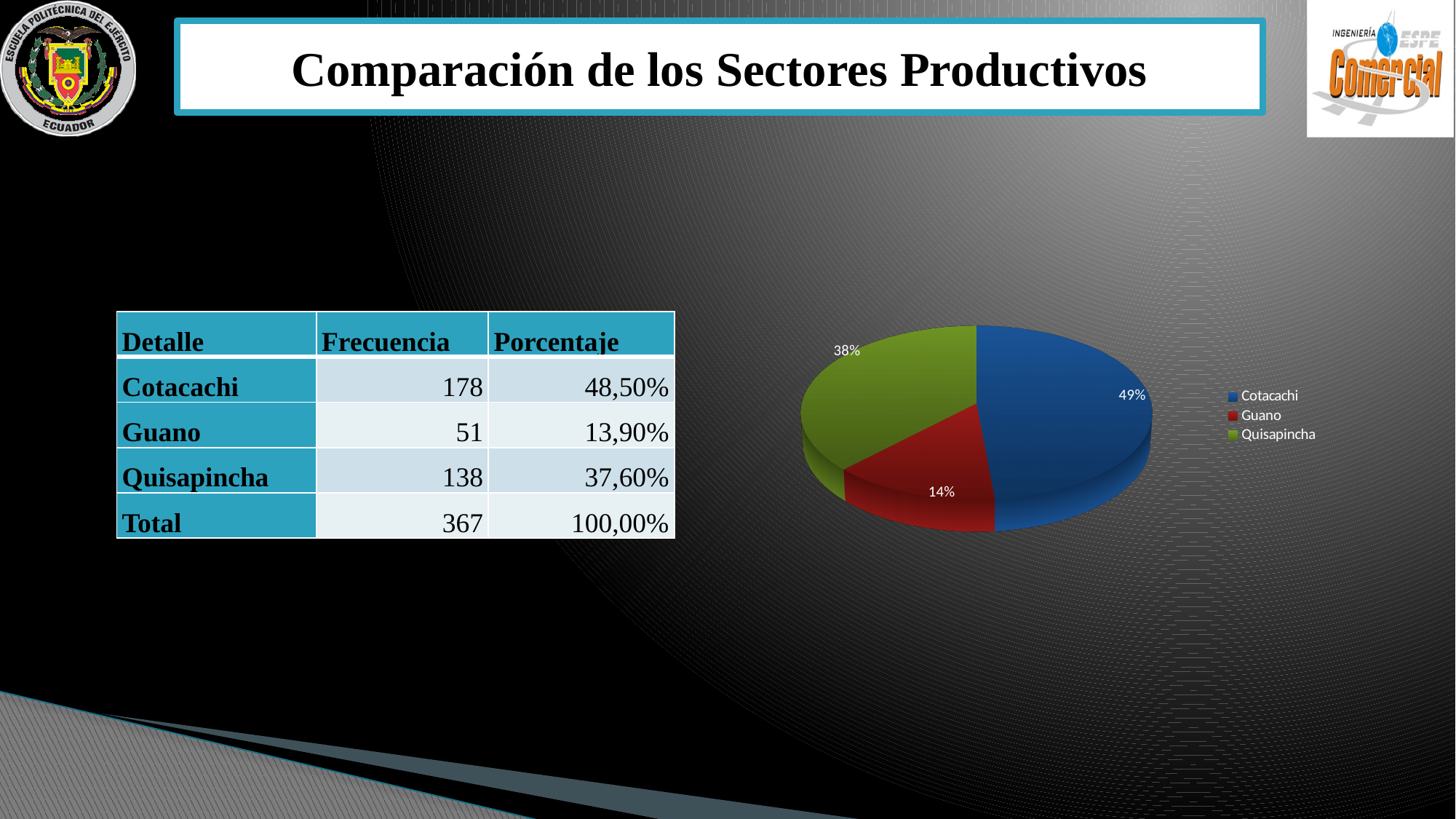
Which category has the smallest slice in the pie chart? Guano By how many percentage points does the Cotacachi slice exceed the Guano slice in the pie chart? 35 percentage points What colour is the Guano slice in the pie chart? red What is the title of the slide containing the pie chart? Comparación de los Sectores Productivos How many entries does the pie chart legend list? 3 Which category has the largest slice in the pie chart? Cotacachi What percentage does the pie chart show for Quisapincha? 38% What percentage does the pie chart show for Cotacachi? 49% What percentage does the pie chart show for Guano? 14% How many slices does the pie chart have? 3 Which slice is larger in the pie chart, Quisapincha or Guano? Quisapincha What kind of chart is shown on the slide? pie chart